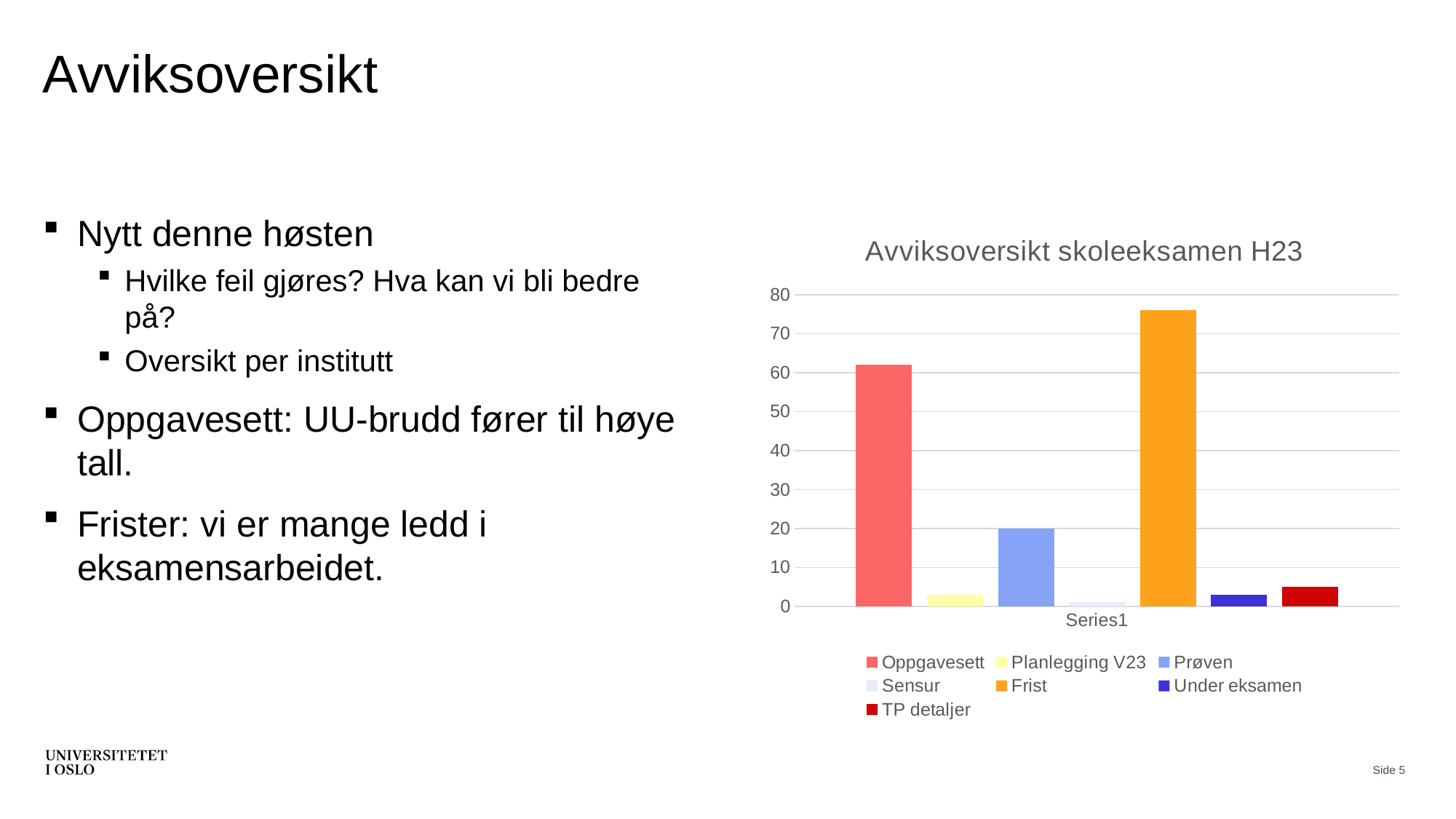
How many series does the chart legend list? 7 What is the title of the chart? Avviksoversikt skoleeksamen H23 Which series has the lowest value in the chart? Sensur Which series has the highest value in the chart? Frist Is the value for Oppgavesett greater or less than 50? greater Is the value for Frist greater or less than 70? greater Which is larger, the value for Oppgavesett or the value for Frist? Frist How many bars are plotted in the chart? 7 What kind of chart is shown on the slide? bar chart Is the value for TP detaljer greater or less than 10? less Which is larger, the value for Prøven or the value for TP detaljer? Prøven What is the value for Prøven? 20